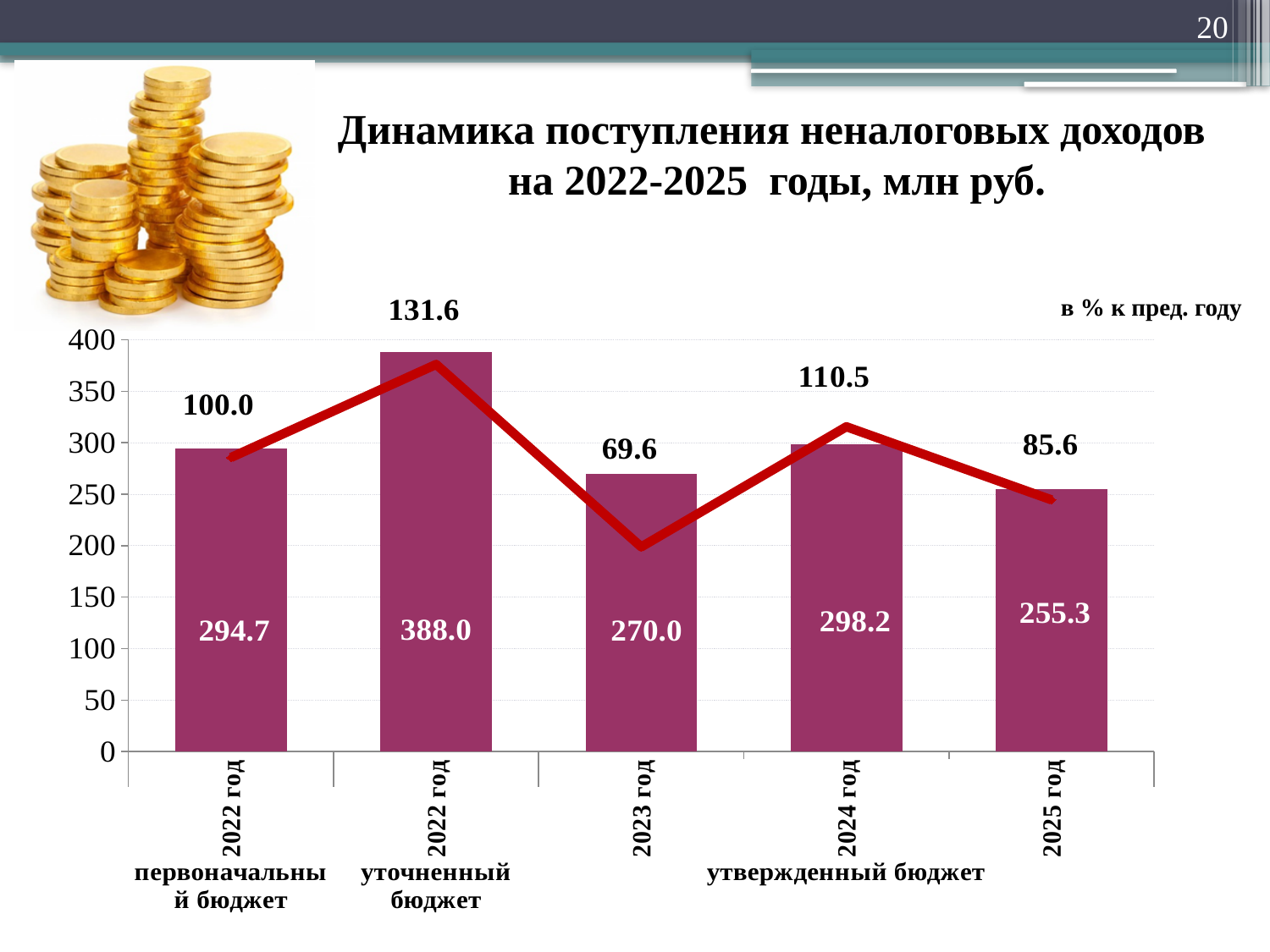
Which bar has the lowest value? 2025 год What is the non-tax revenue value (млн руб.) shown for the 2022 год уточненный бюджет bar? 388.0 What is the title of the chart? Динамика поступления неналоговых доходов на 2022-2025 годы, млн руб. What is the difference between the 2022 год уточненный бюджет bar and the 2022 год первоначальный бюджет bar? 93.3 What kind of chart is shown on the slide? Combined bar and line chart How many bars are plotted in the chart? 5 What percentage to the previous year (в % к пред. году) is shown for 2023 год? 69.6 What is the value shown on the bar for 2025 год? 255.3 What percentage to the previous year is shown for 2024 год? 110.5 Which is larger, the bar for 2024 год or the bar for 2023 год? 2024 год Which bar has the highest value? 2022 год уточненный бюджет Do the bar values rise or fall from 2024 год to 2025 год? Fall